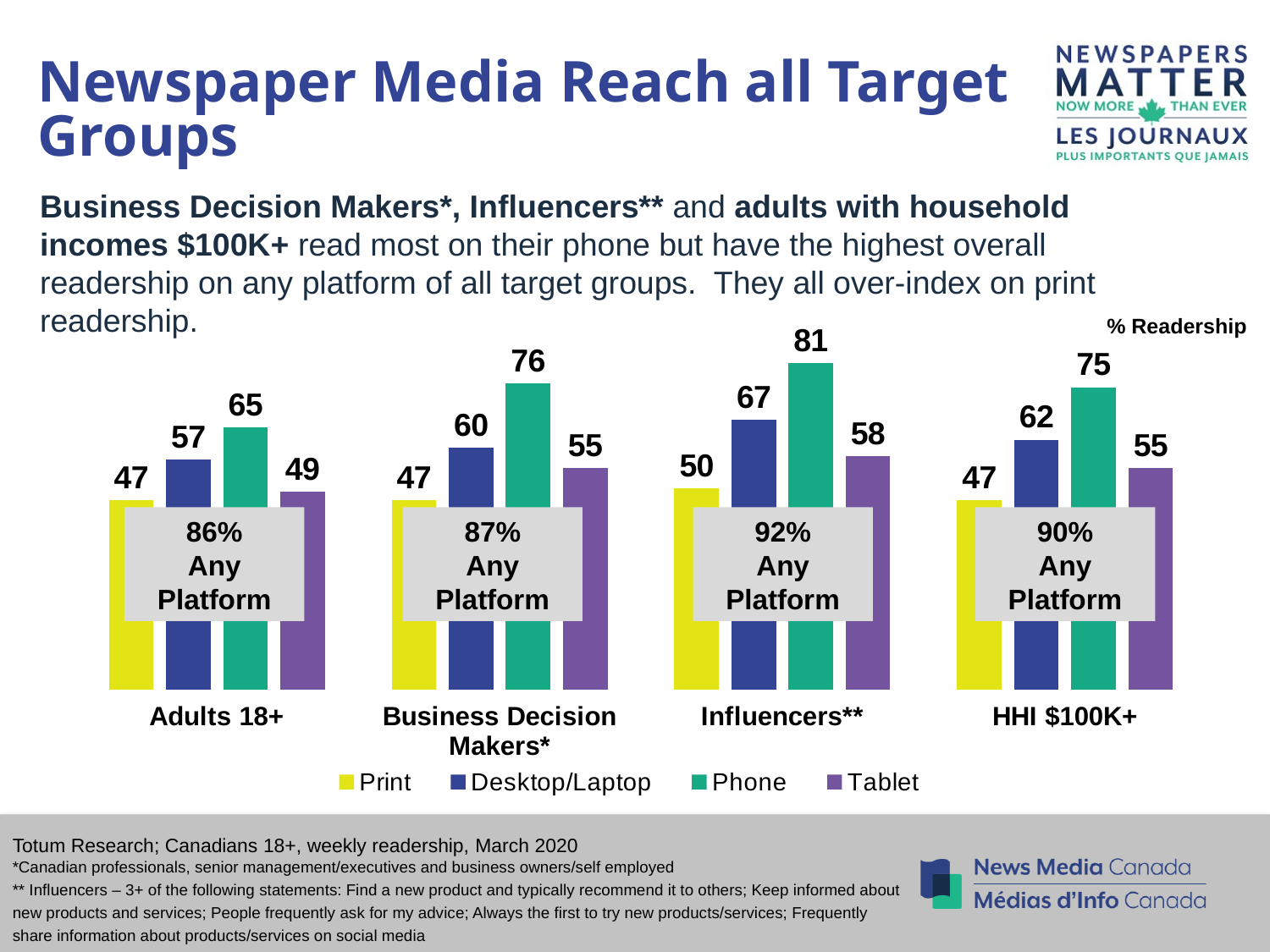
How many series does the chart legend list? 4 Which series in the legend is shown in yellow? Print What is the 'Any Platform' readership shown for Influencers**? 92% What kind of chart is shown on the slide? Bar chart Which target group has the lowest Desktop/Laptop readership? Adults 18+ What is the Desktop/Laptop readership value for HHI $100K+? 62 Which is larger for Adults 18+: Desktop/Laptop readership or Tablet readership? Desktop/Laptop Which target group has the highest Phone readership? Influencers** What is the difference between the Phone and Print readership values for Business Decision Makers*? 29 What is the Tablet readership value for Adults 18+? 49 What is the Phone readership value for Influencers**? 81 How many target groups are shown on the x axis of the chart? 4